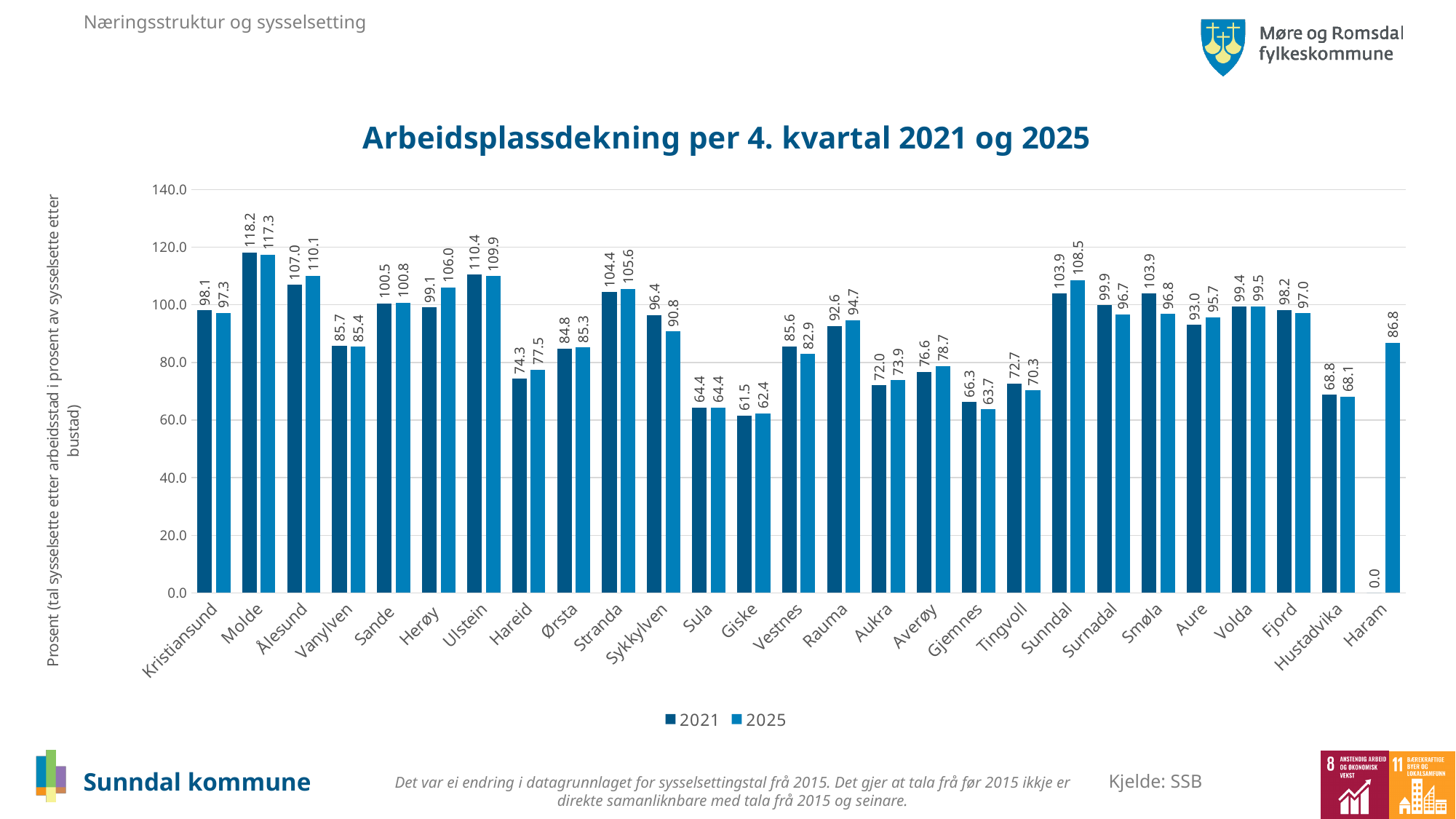
What is the difference between the 2025 and 2021 values for Sunndal? 4.6 What is the title of the chart? Arbeidsplassdekning per 4. kvartal 2021 og 2025 What is the 2021 value for Sunndal? 103.9 What is the 2025 value for Sunndal? 108.5 Which is larger for Sykkylven, the 2021 value or the 2025 value? 2021 Is the 2025 value for Ulstein greater or less than 100.0? greater What is the 2025 value for Haram? 86.8 How many series does the legend list? 2 What type of chart is shown on the slide? bar chart Which municipality has the lowest 2025 value? Giske How many municipalities are shown on the x axis? 27 Which municipality has the highest 2021 value? Molde